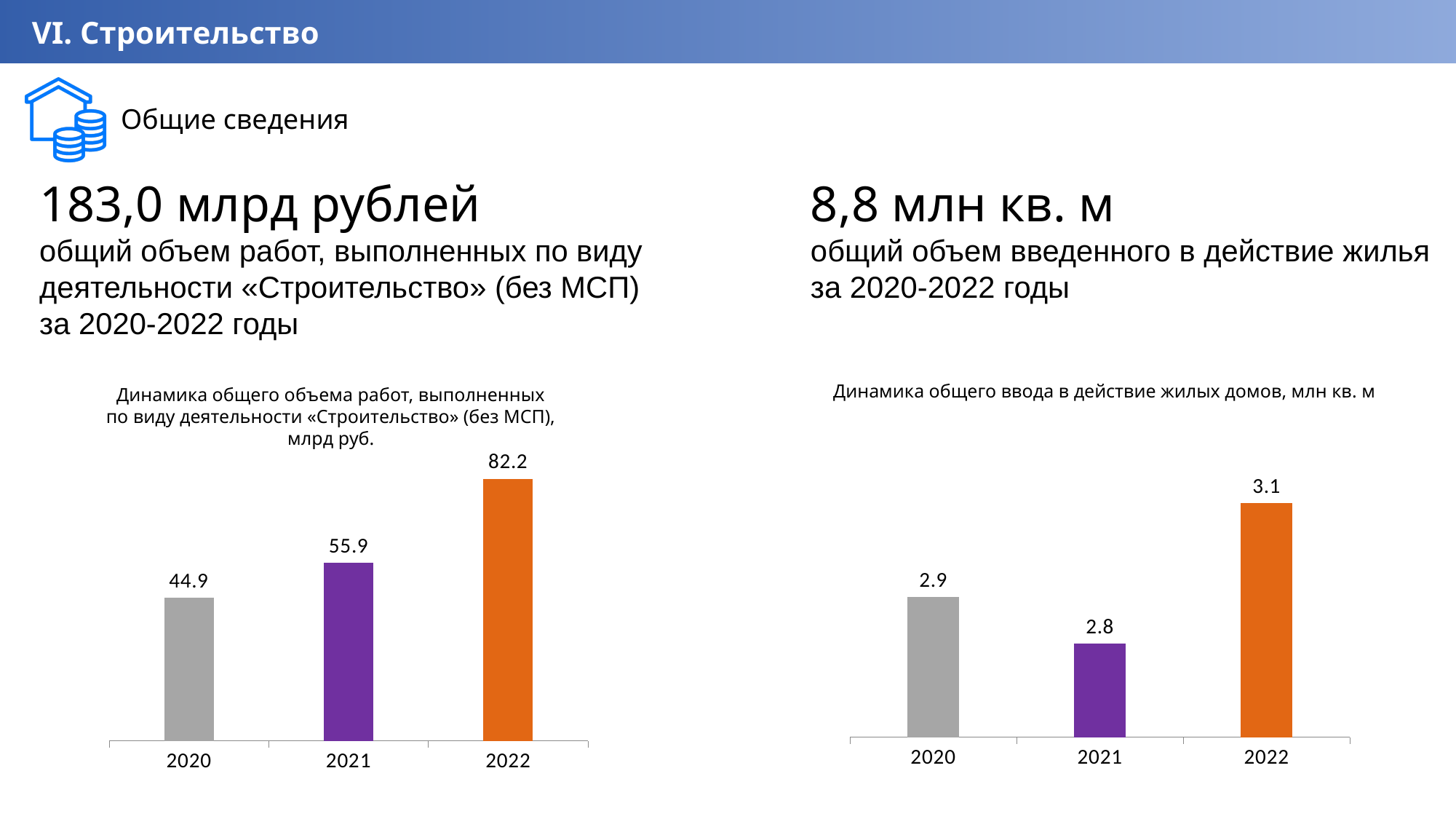
In the left chart (Динамика общего объема работ, выполненных по виду деятельности «Строительство» (без МСП), млрд руб.), what is the value for 2021? 55.9 In the left chart (Динамика общего объема работ), which year has the lowest value? 2020 In the right chart (Динамика общего ввода в действие жилых домов), which year has the lowest value? 2021 In the left chart (Динамика общего объема работ), do the values rise or fall from 2020 to 2022? rise What kind of chart is the right chart (Динамика общего ввода в действие жилых домов)? bar chart How many bars does the left chart (Динамика общего объема работ) have? 3 In the right chart (Динамика общего ввода в действие жилых домов, млн кв. м), what is the value for 2020? 2.9 In the left chart (Динамика общего объема работ), which year has the highest value? 2022 In the right chart (Динамика общего ввода в действие жилых домов), which is larger, the value for 2020 or the value for 2021? 2020 In the right chart (Динамика общего ввода в действие жилых домов), what is the difference between the values for 2022 and 2021? 0.3 In the left chart (Динамика общего объема работ), what is the difference between the values for 2022 and 2020? 37.3 In the right chart (Динамика общего ввода в действие жилых домов), which year has the highest value? 2022